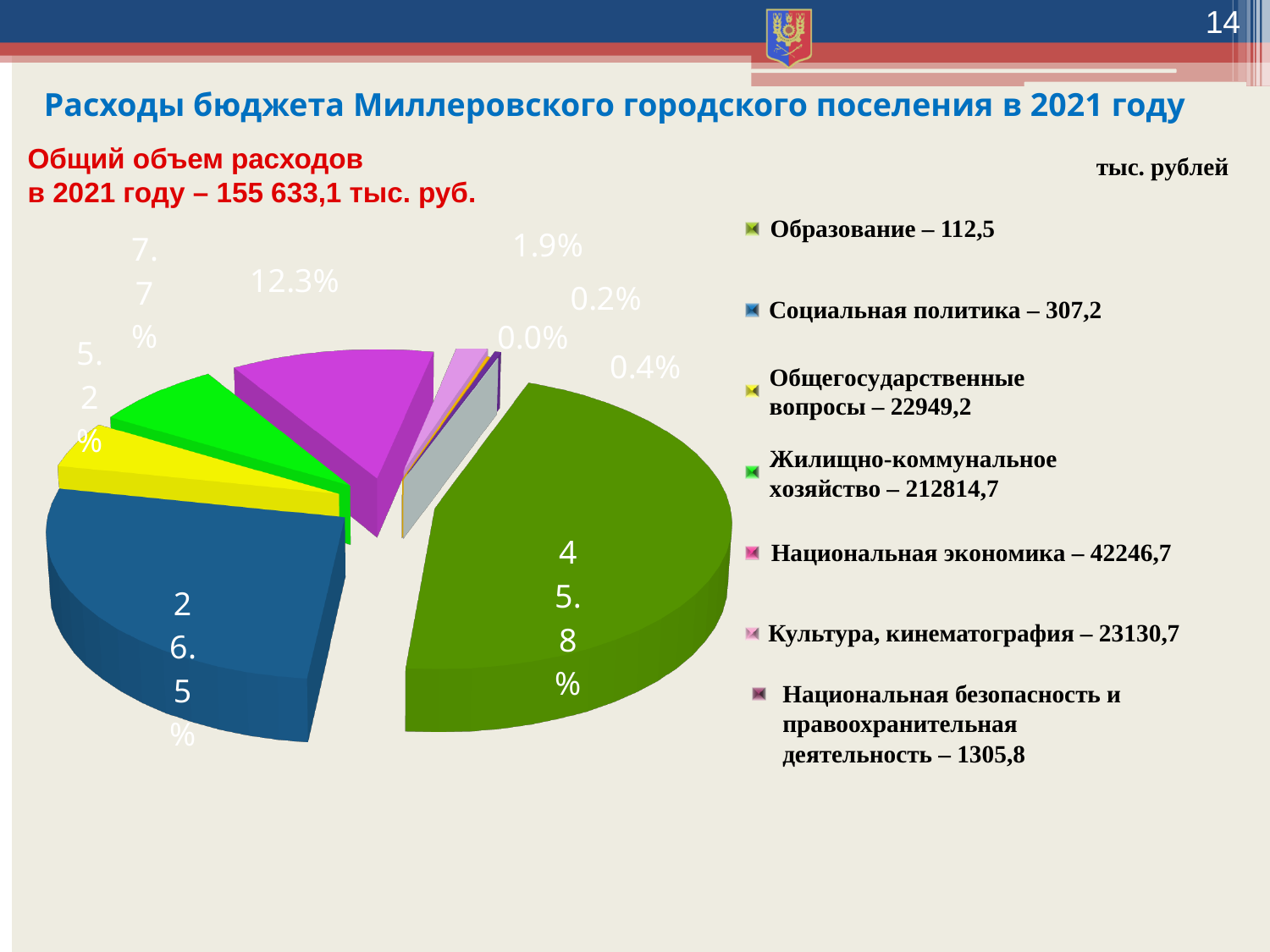
Which legend entry has the largest value? Жилищно-коммунальное хозяйство Which legend entry has the smallest value? Образование What unit is stated for the values in the legend? тыс. рублей What percentage is shown on the largest slice of the pie chart? 45.8% What percentage is shown on the blue slice of the pie chart? 26.5% According to the legend, what is the value for Национальная безопасность и правоохранительная деятельность? 1305,8 According to the legend, what is the value for Национальная экономика? 42246,7 What is the difference between the legend values for Культура, кинематография and Общегосударственные вопросы? 181,5 According to the legend, what is the value for Образование? 112,5 How many categories does the legend list? 7 What kind of chart is shown on the slide? pie chart Which is larger according to the legend: Общегосударственные вопросы or Культура, кинематография? Культура, кинематография